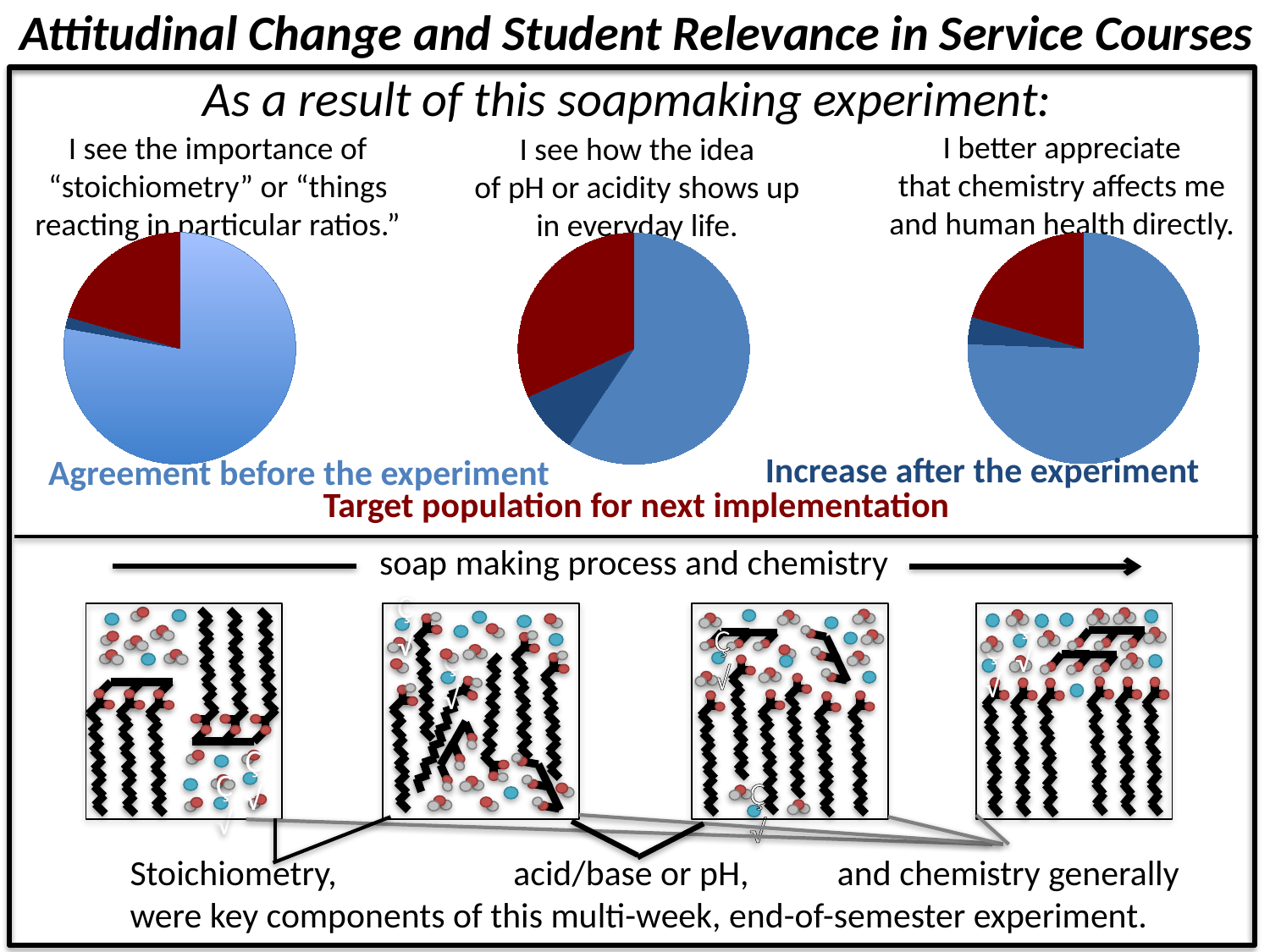
Which colour represents "Target population for next implementation" in the pie charts? Dark red In the pie chart for "I see how the idea of pH or acidity shows up in everyday life", which category has the largest slice? Agreement before the experiment How many pie charts are shown on the slide? 3 In the pie chart for "I see the importance of 'stoichiometry'", which category has the largest slice? Agreement before the experiment In the pie chart for "I better appreciate that chemistry affects me and human health directly", which category has the largest slice? Agreement before the experiment In the pie chart for "I better appreciate that chemistry affects me and human health directly", which category has the smallest slice? Increase after the experiment In the pie chart for "I see the importance of 'stoichiometry'", which category has the smallest slice? Increase after the experiment What is the heading above the three pie charts? As a result of this soapmaking experiment: In the pie chart for "I see how the idea of pH or acidity shows up in everyday life", which category has the smallest slice? Increase after the experiment What kind of chart is used to show the responses to "I see the importance of 'stoichiometry'"? Pie chart In the pie chart for "I see how the idea of pH or acidity shows up in everyday life", which slice is larger: "Target population for next implementation" or "Increase after the experiment"? Target population for next implementation How many categories does the legend list for the pie charts? 3